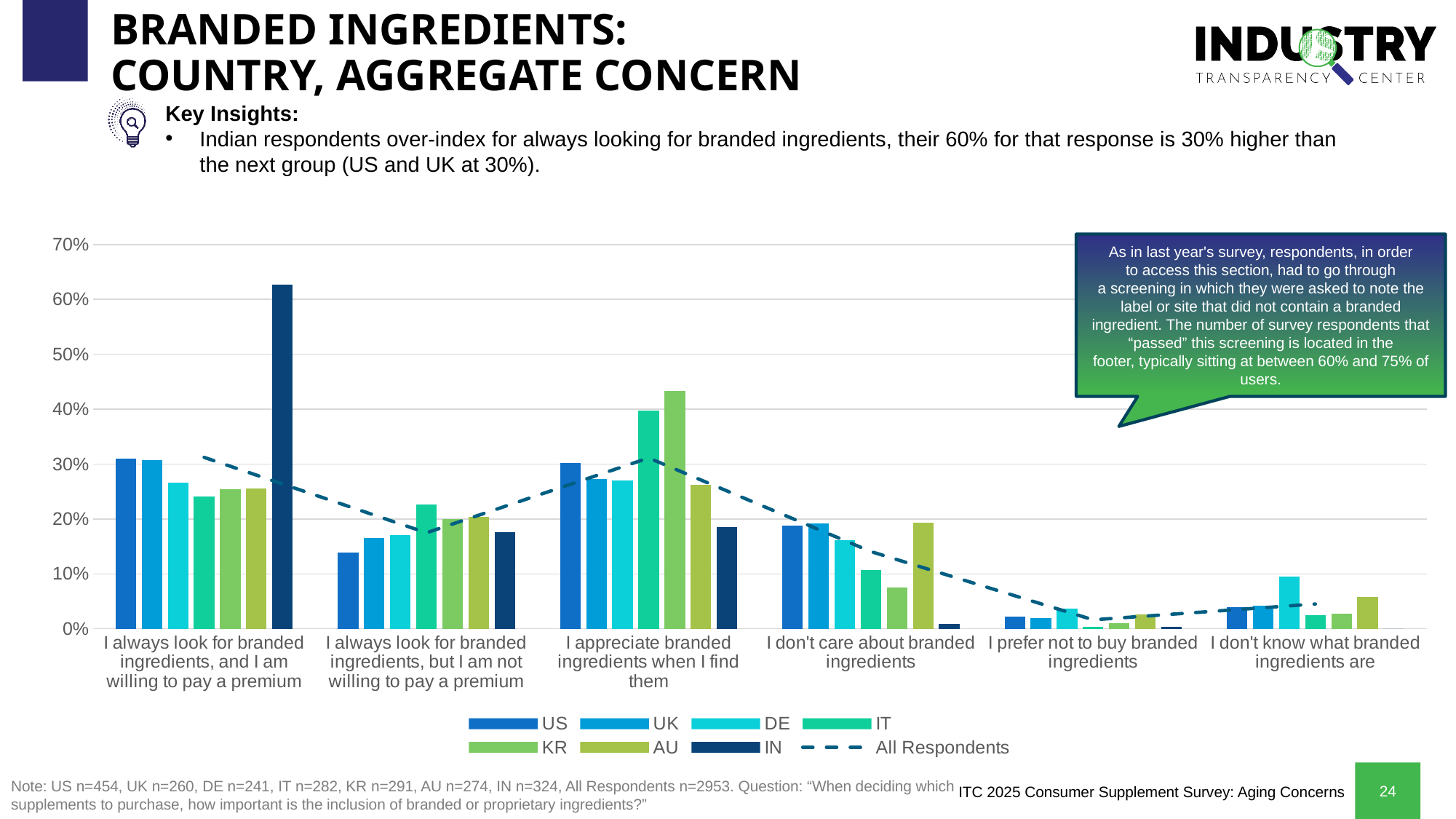
What kind of chart is shown on the slide? combination bar and line chart Which country has the lowest bar for "I always look for branded ingredients, but I am not willing to pay a premium"? US Is the US value for "I always look for branded ingredients, but I am not willing to pay a premium" greater or less than 20%? less How many response categories are shown along the x axis? 6 Which country has the lowest bar for "I don't care about branded ingredients"? IN Is the IN value for "I always look for branded ingredients, and I am willing to pay a premium" greater or less than 60%? greater Which country has the highest bar for "I always look for branded ingredients, and I am willing to pay a premium"? IN How many series does the legend list? 8 For "I don't know what branded ingredients are", which is larger, the DE bar or the AU bar? DE Which country has the highest bar for "I appreciate branded ingredients when I find them"? KR Does the All Respondents dashed line rise or fall from "I appreciate branded ingredients when I find them" to "I prefer not to buy branded ingredients"? fall Is the KR value for "I appreciate branded ingredients when I find them" greater or less than 40%? greater